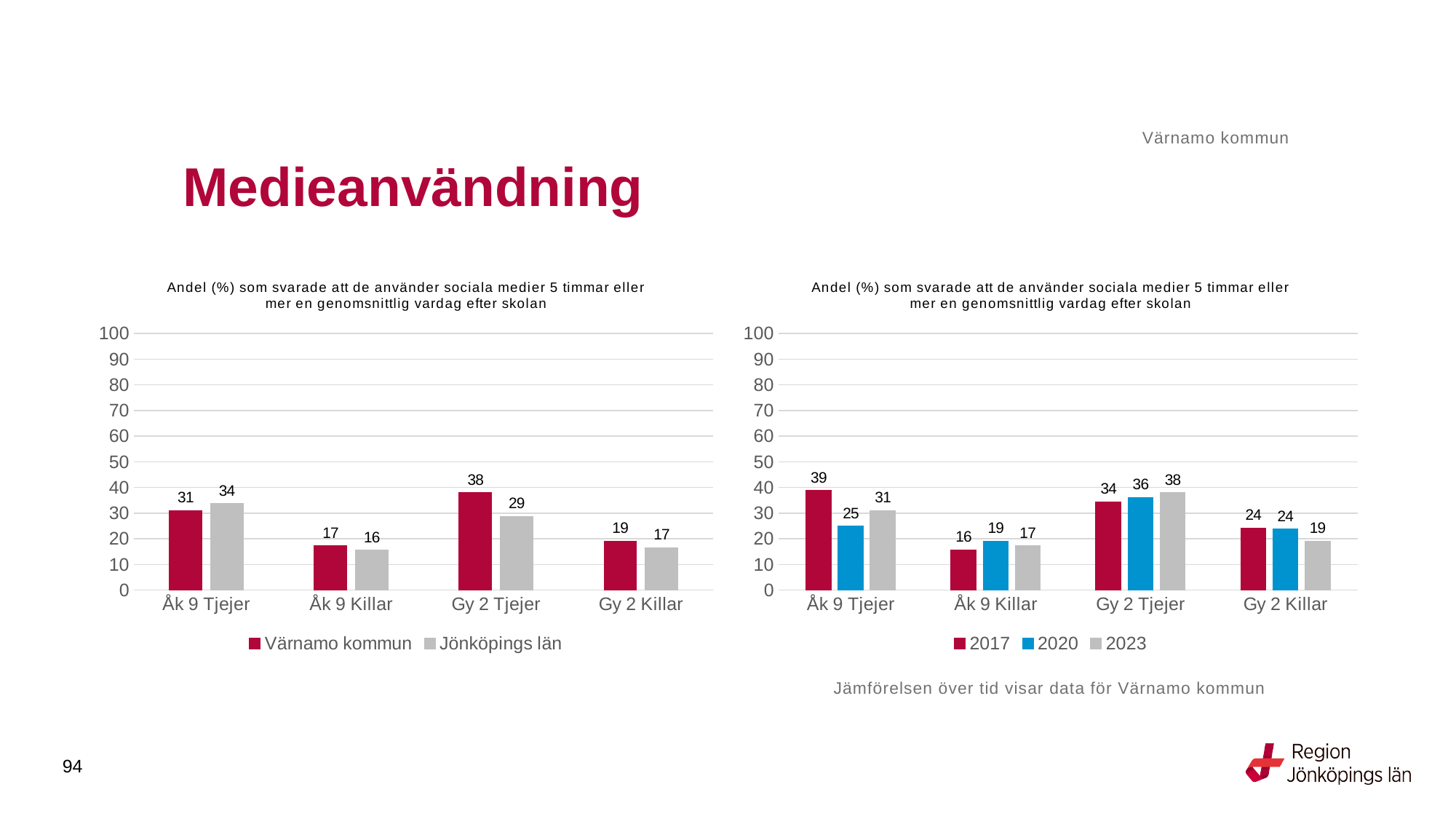
In the left chart, how many series does the legend list? 2 In the right chart, what is the value for 2023 for Gy 2 Killar? 19 In the left chart, which is larger for Åk 9 Tjejer: Värnamo kommun or Jönköpings län? Jönköpings län In the right chart, do the values for Gy 2 Tjejer rise or fall from 2017 to 2023? rise In the right chart, what is the difference between 2017 and 2020 for Åk 9 Tjejer? 14 In the left chart, what is the difference between Värnamo kommun and Jönköpings län for Gy 2 Tjejer? 9 In the left chart, what is the value for Värnamo kommun for Gy 2 Tjejer? 38 What kind of chart is the right chart? bar chart In the right chart, what is the value for 2020 for Åk 9 Tjejer? 25 In the left chart, what is the value for Jönköpings län for Åk 9 Killar? 16 In the right chart, which category has the lowest value for 2017? Åk 9 Killar In the left chart, which category has the highest value for Värnamo kommun? Gy 2 Tjejer